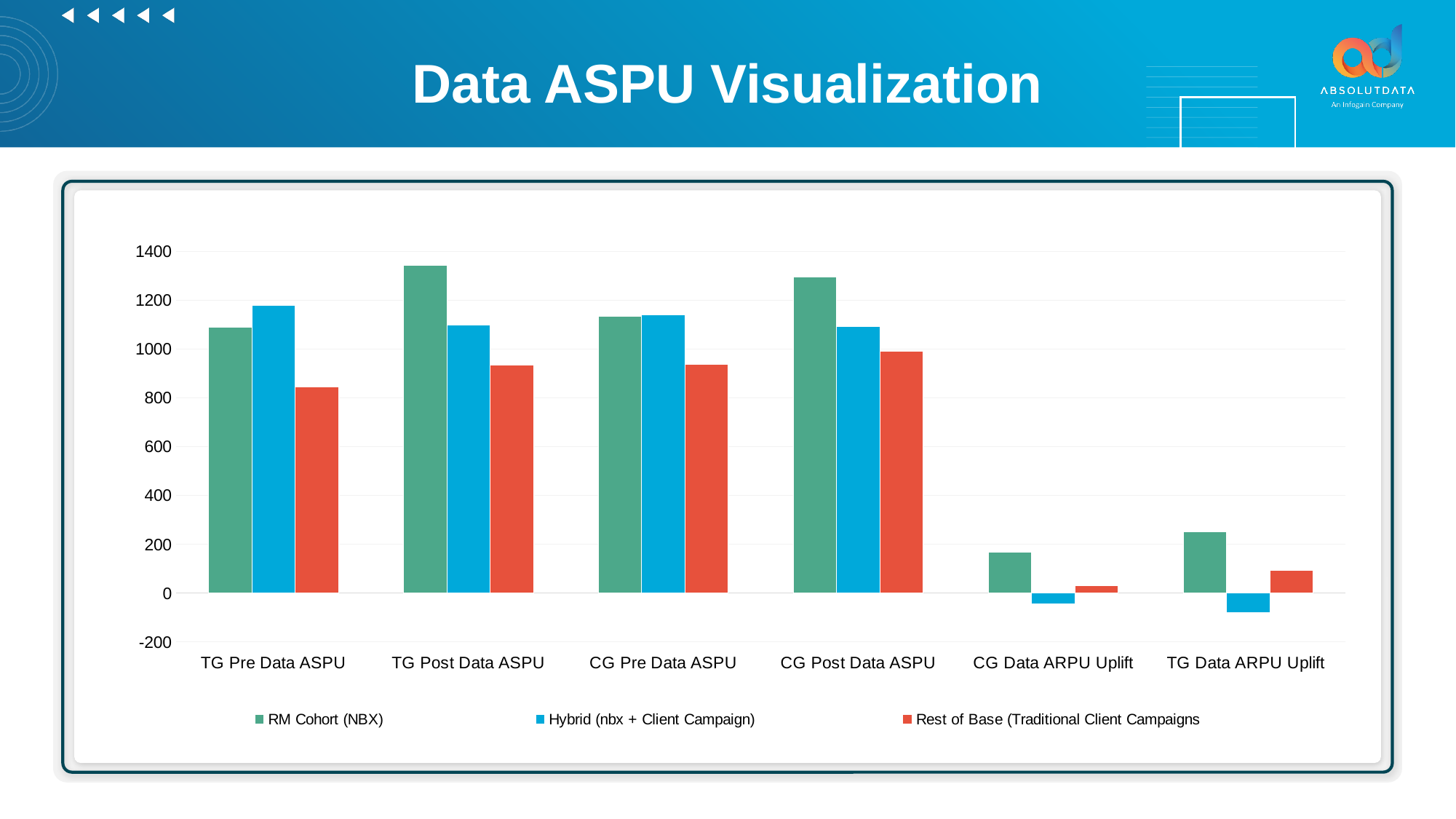
Is the RM Cohort (NBX) value for TG Post Data ASPU greater or less than 1200? greater For TG Pre Data ASPU, which is larger: the RM Cohort (NBX) value or the Hybrid (nbx + Client Campaign) value? Hybrid (nbx + Client Campaign) How many categories are shown along the x axis? 6 Is the RM Cohort (NBX) value for CG Data ARPU Uplift greater or less than 200? less For which category is the Hybrid (nbx + Client Campaign) bar the lowest? TG Data ARPU Uplift What is the title of the slide containing the chart? Data ASPU Visualization Is the Rest of Base (Traditional Client Campaigns) value for TG Pre Data ASPU greater or less than 1000? less How many series does the legend list? 3 For CG Post Data ASPU, which is larger: the RM Cohort (NBX) value or the Rest of Base (Traditional Client Campaigns) value? RM Cohort (NBX) What kind of chart is shown on the slide? bar chart For which category is the RM Cohort (NBX) bar the highest? TG Post Data ASPU